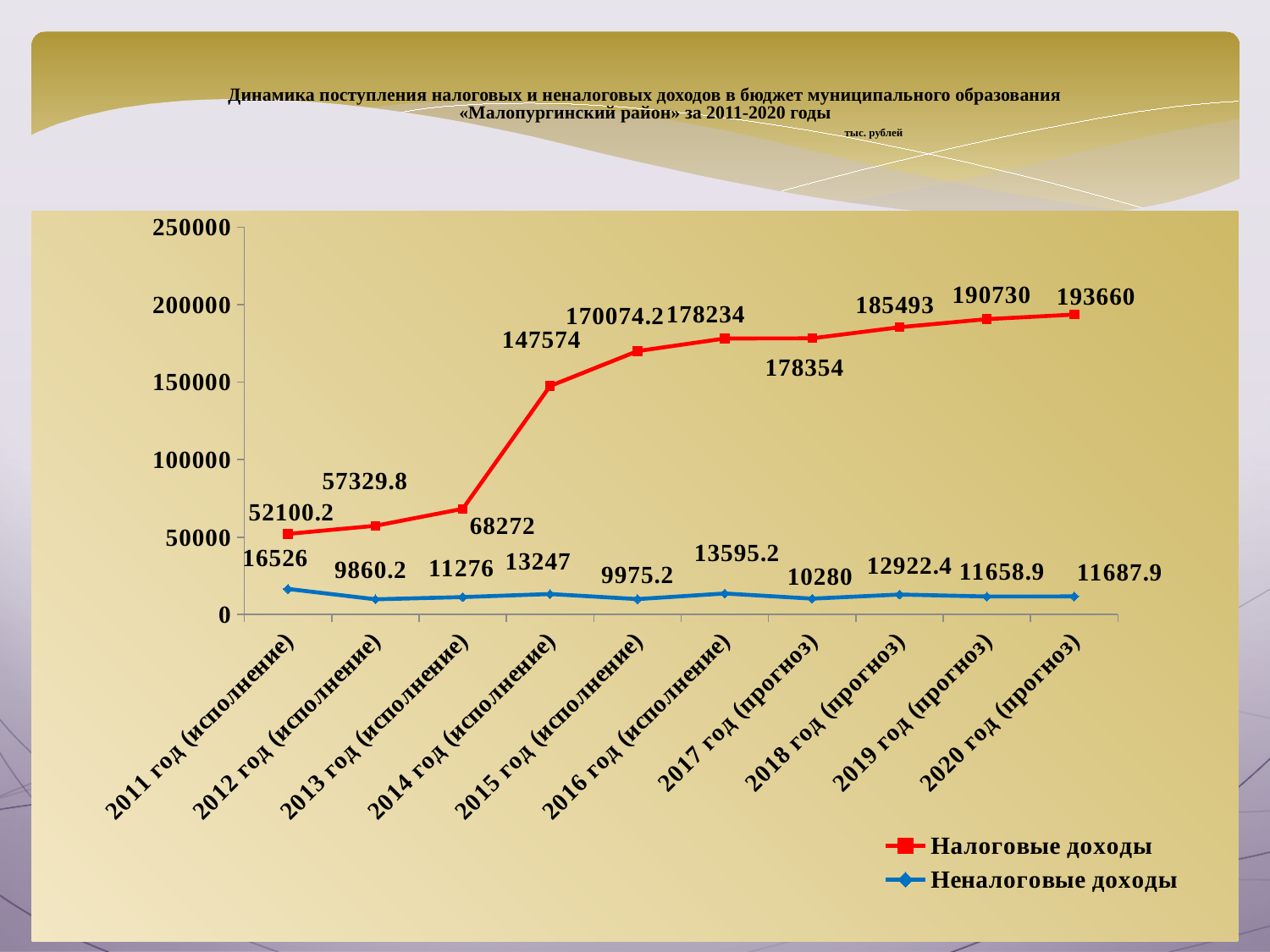
What type of chart is shown on the slide? line chart What is the value of Налоговые доходы for 2020 год (прогноз)? 193660 What is the value of Налоговые доходы for 2014 год (исполнение)? 147574 Which series is drawn in red? Налоговые доходы In which year is Неналоговые доходы highest? 2011 год (исполнение) What is the difference between Налоговые доходы in 2014 год (исполнение) and 2013 год (исполнение)? 79302 How many years (categories) are plotted along the x axis? 10 What is the value of Неналоговые доходы for 2016 год (исполнение)? 13595.2 How many series does the legend list? 2 In which year is Налоговые доходы lowest? 2011 год (исполнение) Does Налоговые доходы generally rise or fall from 2011 to 2020? rise Which is larger: Неналоговые доходы in 2012 год (исполнение) or in 2013 год (исполнение)? 2013 год (исполнение)